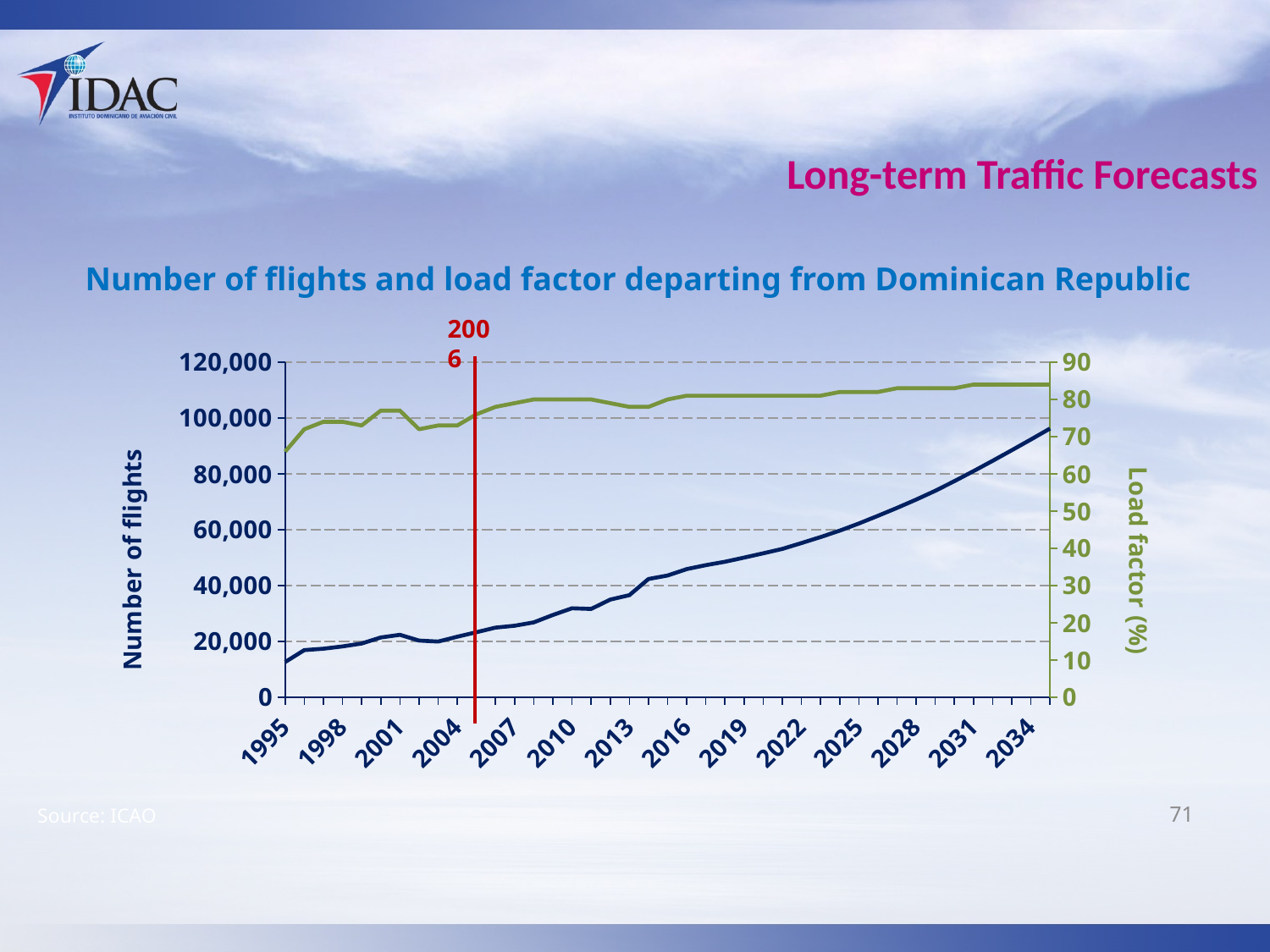
Is the number of flights in 2034 greater or less than 80,000? greater Is the number of flights in 2022 greater or less than 40,000? greater Is the load factor in 2010 greater or less than 70? greater In which year is the number of flights lowest? 1995 What kind of chart is shown on the slide? line chart Which year is marked by the red vertical line on the chart? 2006 How many year labels are shown on the x axis? 14 Does the number of flights rise or fall from 1995 to 2034? rise